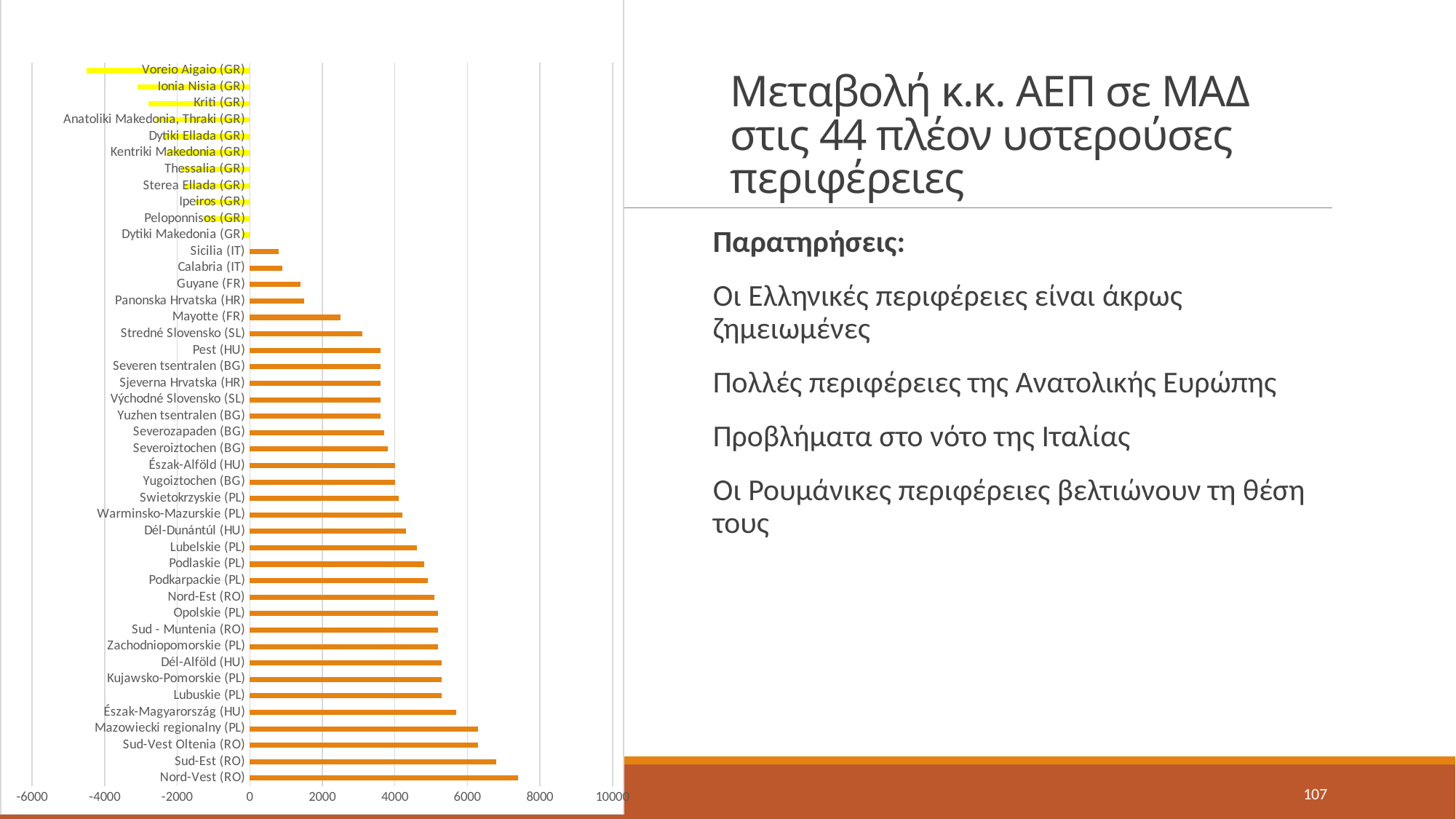
How many regions are plotted in the chart? 44 Is the value for Voreio Aigaio (GR) greater or less than -4000? less Which region has the highest value in the chart? Nord-Vest (RO) Is the value for Kriti (GR) greater or less than -2000? less Is the value for Mayotte (FR) greater or less than 2000? greater Which region has the lowest value in the chart? Voreio Aigaio (GR) Which has the larger value, Mayotte (FR) or Guyane (FR)? Mayotte (FR) What colour are the bars for the Greek (GR) regions? yellow Which has the larger value, Dytiki Makedonia (GR) or Voreio Aigaio (GR)? Dytiki Makedonia (GR) What kind of chart is shown on the slide? bar chart